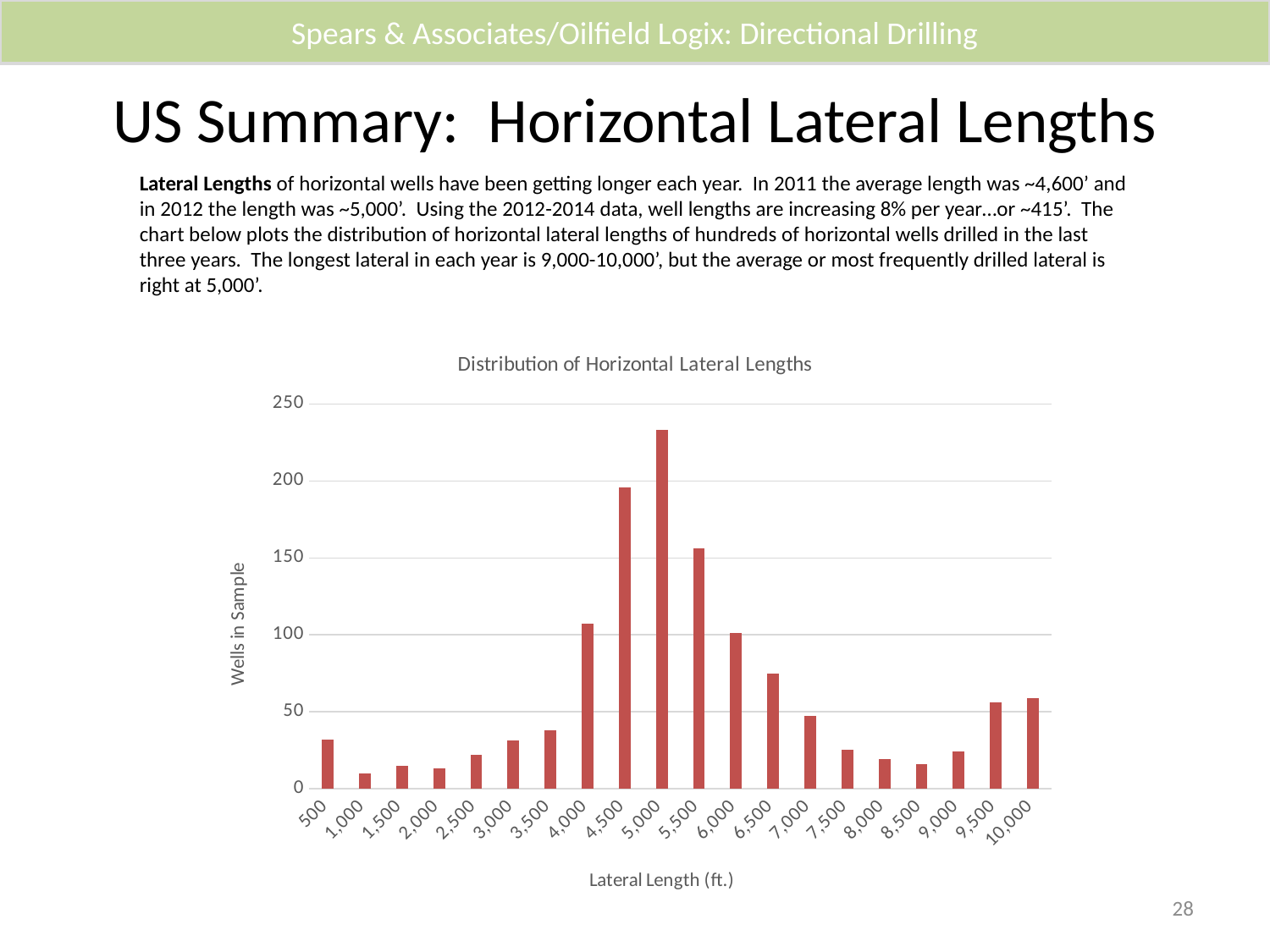
Is the value for 3,500 greater or less than 50? less Is the value for 4,500 greater or less than 150? greater What is the title of the chart? Distribution of Horizontal Lateral Lengths What is the label of the vertical axis of the chart? Wells in Sample Moving from 5,000 to 8,500 along the x axis, do the values rise or fall? fall Which lateral length has the highest number of wells in the sample? 5,000 Is the value for 6,500 greater or less than 50? greater How many lateral length categories are plotted on the x axis? 20 What kind of chart is shown on the slide? bar chart Which has more wells in the sample, 4,500 or 5,500? 4,500